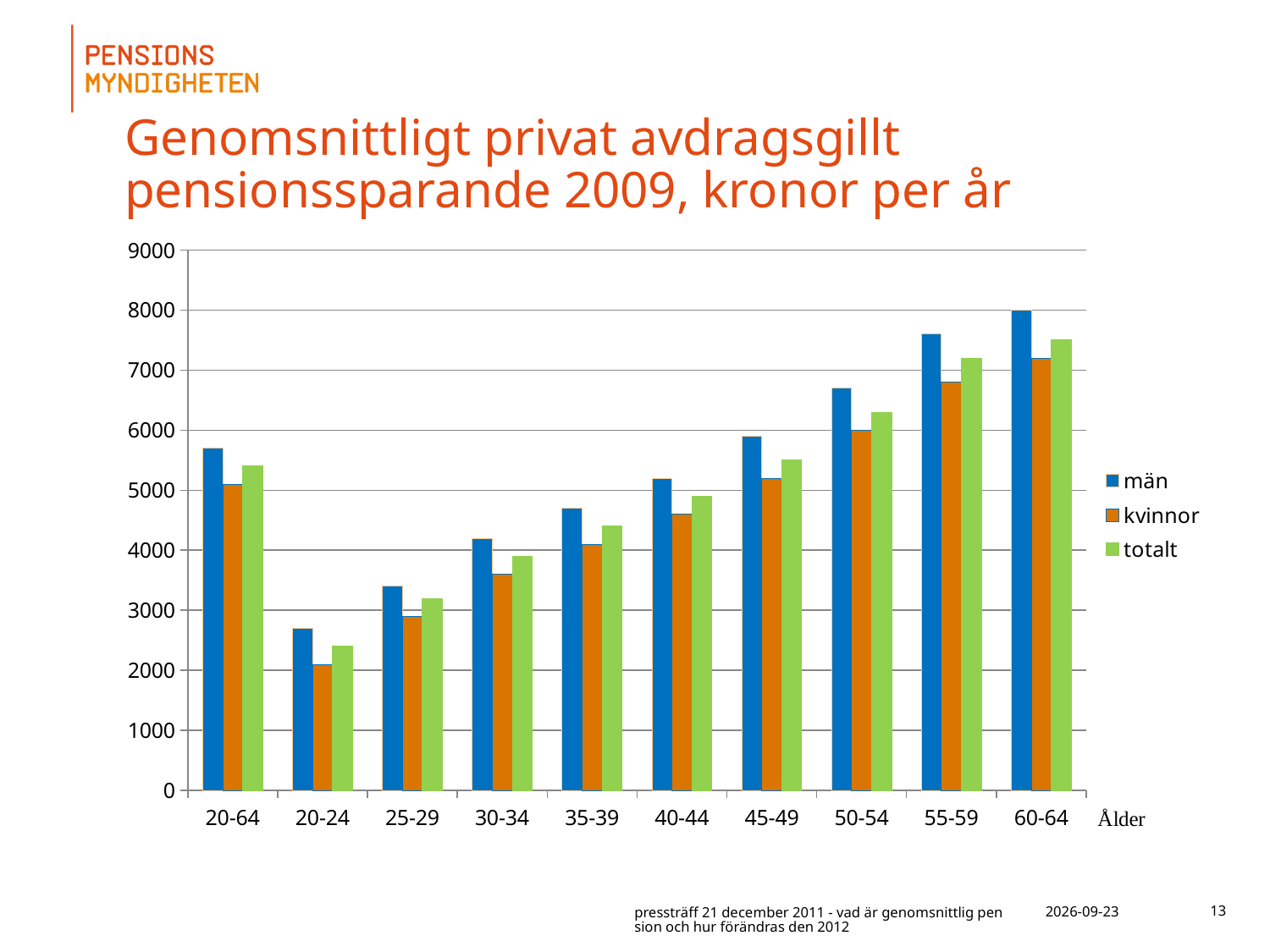
How many age groups are shown along the x axis? 10 Which age group has the lowest value for kvinnor? 20-24 Which is larger, the value for totalt in the 20-64 group or the value for totalt in the 30-34 group? 20-64 Which is larger in the 35-39 age group, the value for män or the value for kvinnor? män What kind of chart is shown on the slide? bar chart Which age group has the highest value for män? 60-64 From the 20-24 age group to the 60-64 age group, do the values for totalt rise or fall? rise Is the value for kvinnor in the 20-24 age group greater or less than 3000? less What are the three series named in the legend? män, kvinnor, totalt How many series does the legend list? 3 Is the value for män in the 60-64 age group greater or less than 7000? greater Is the value for totalt in the 45-49 age group greater or less than 5000? greater